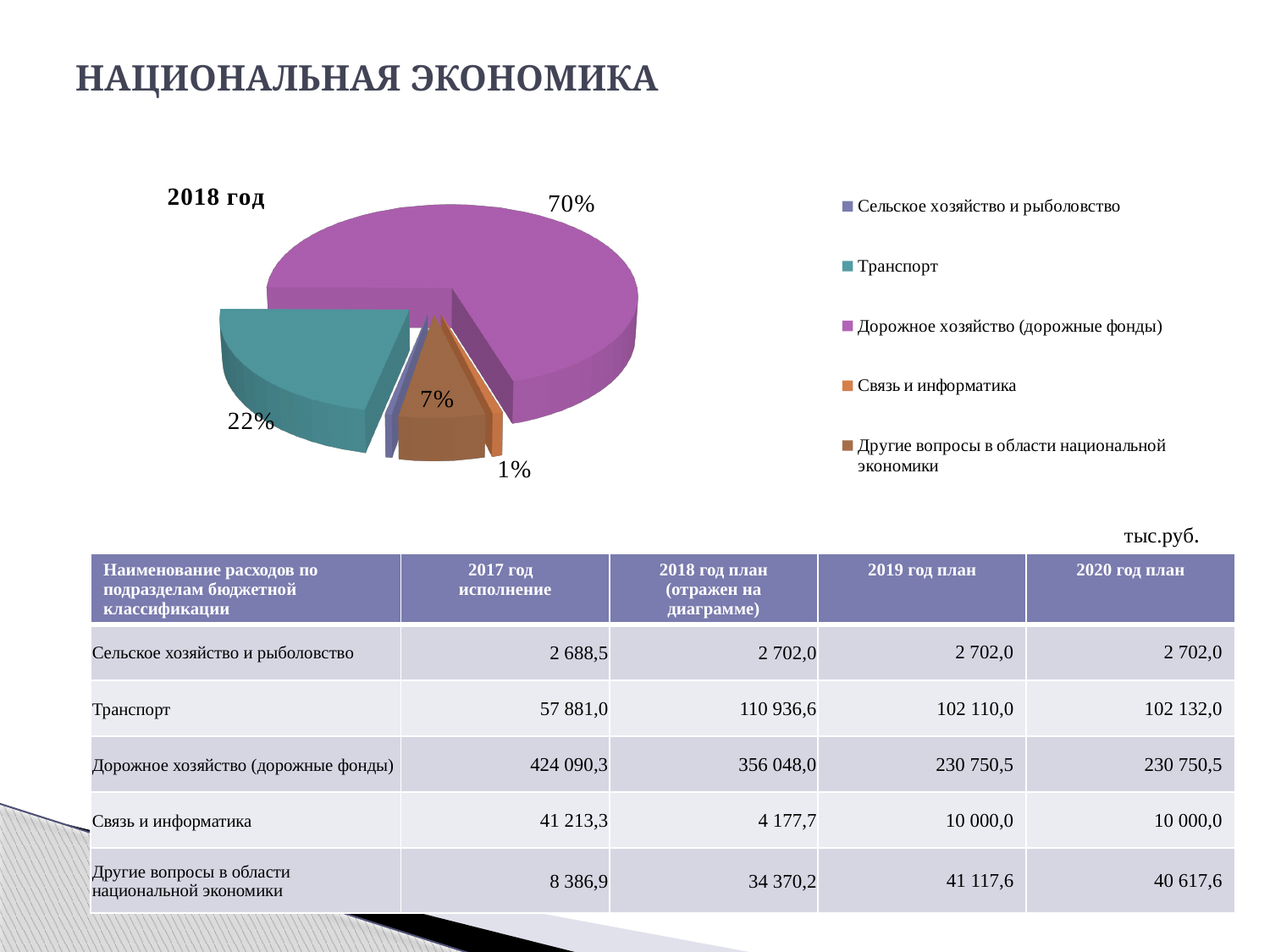
Which category has the largest slice of the pie? Дорожное хозяйство (дорожные фонды) Which slice is larger, Связь и информатика or Другие вопросы в области национальной экономики? Другие вопросы в области национальной экономики What is the difference in percentage points between the Дорожное хозяйство (дорожные фонды) slice and the Транспорт slice? 48% What share of the pie does Транспорт have? 22% What colour is the Дорожное хозяйство (дорожные фонды) slice in the pie chart? purple What share of the pie does Дорожное хозяйство (дорожные фонды) have? 70% Which slice is larger, Транспорт or Другие вопросы в области национальной экономики? Транспорт What share of the pie does Связь и информатика have? 1% What is the title of the pie chart? 2018 год How many entries does the legend of the pie chart list? 5 What kind of chart is shown on the slide? pie chart